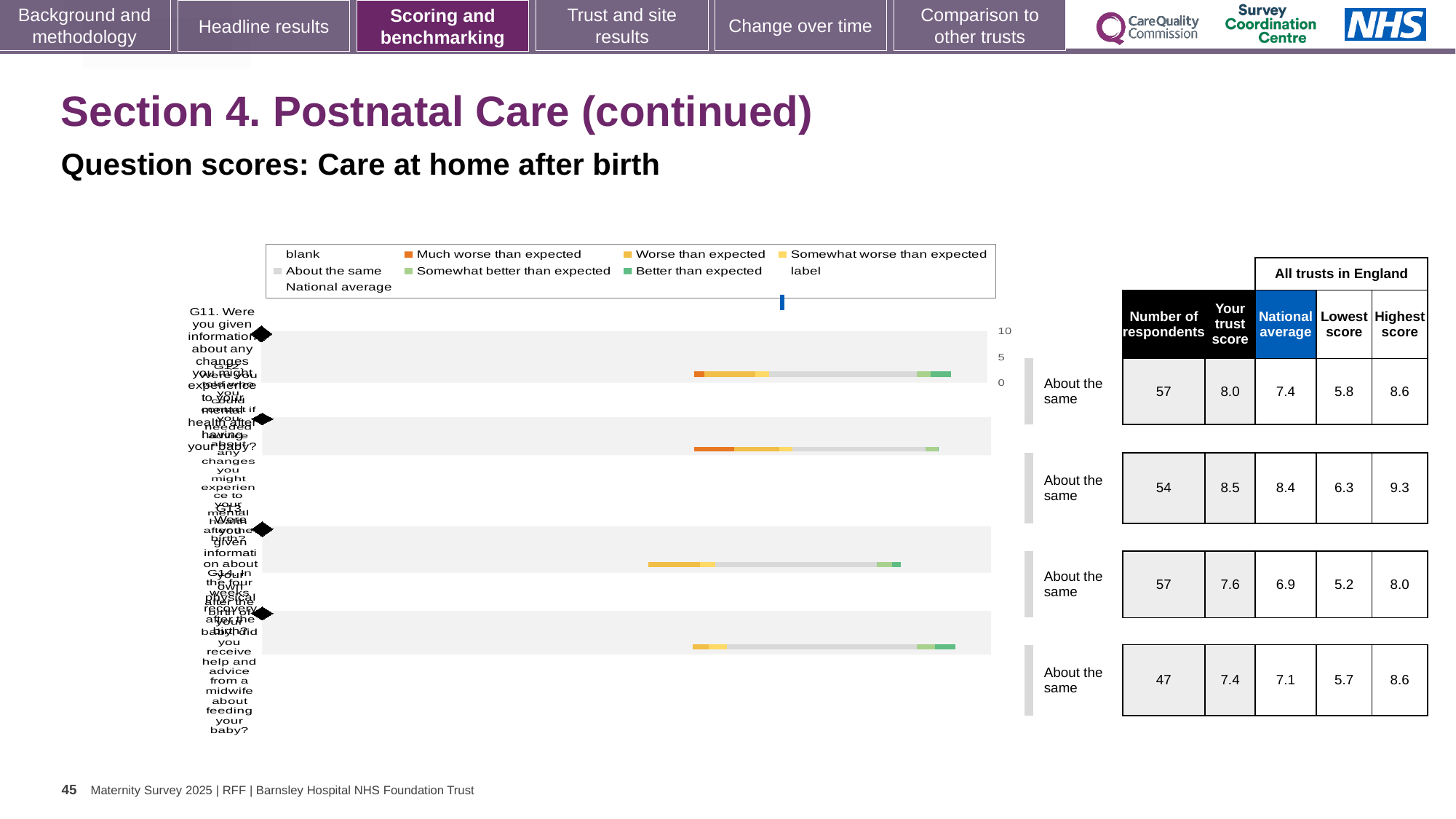
What benchmark category label is shown beside each of the four bars in the chart? About the same How many question rows (bars) are plotted in the chart? 4 Which row in the table has the lowest 'National average'? the third row (6.9) What kind of chart is shown on the slide? bar chart In the table next to the chart, what is the 'Your trust score' value for the second row? 8.5 For the first row of the table, which is larger: 'Your trust score' or the 'National average'? Your trust score (8.0) What is the 'Lowest score' value for the second row of the table? 6.3 In the table next to the chart, what is the number of respondents for the first (top) row? 57 For the third row of the table, how much higher is 'Your trust score' than the 'National average'? 0.7 Which row in the table has the highest 'Your trust score'? the second row (8.5) For the second row of the table, what is the difference between the 'Highest score' and the 'Lowest score'? 3.0 What is the 'Highest score' value for the fourth (bottom) row of the table? 8.6